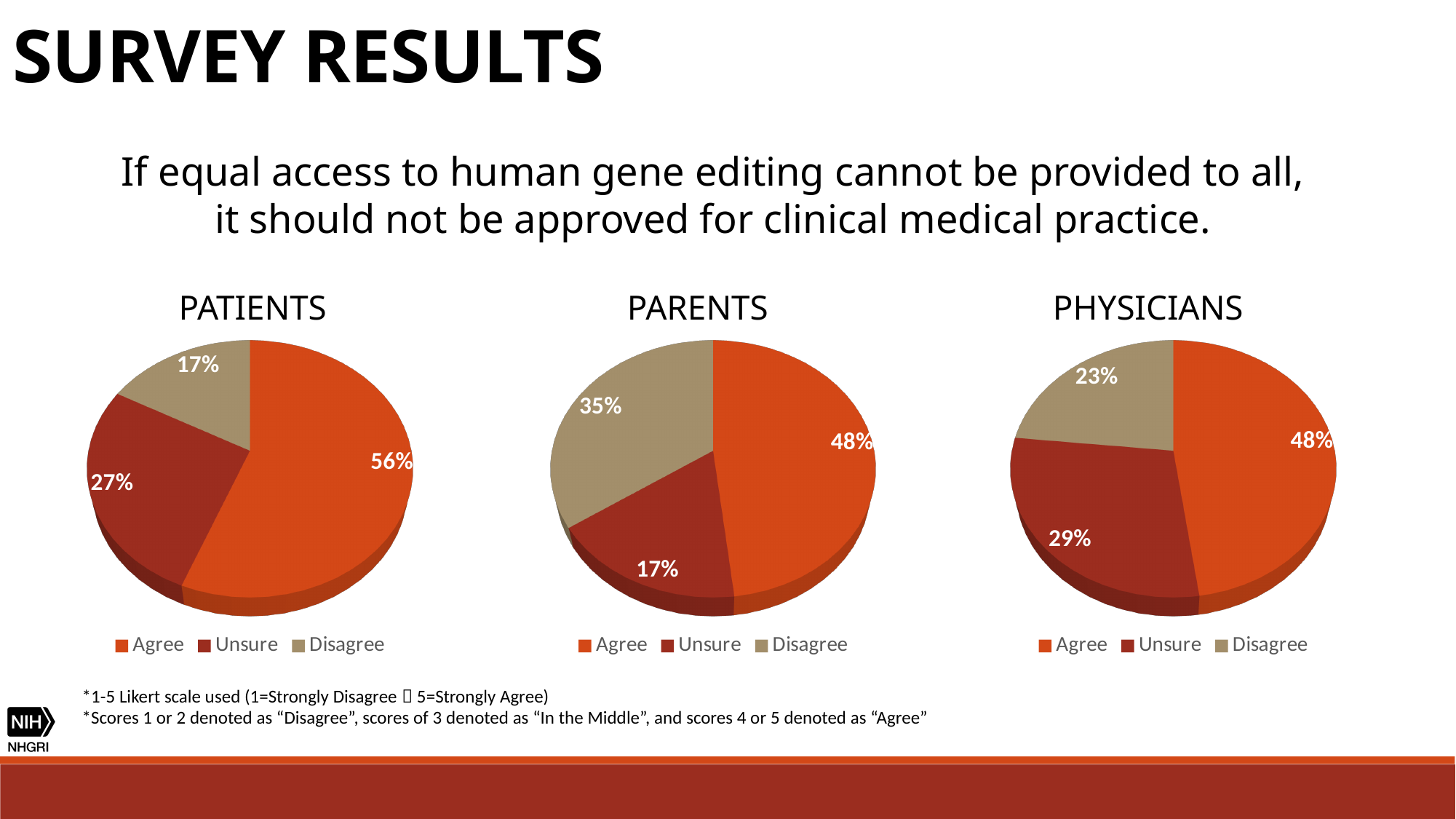
In the PATIENTS chart, which response has the smallest slice? Disagree How many entries does the legend of the PARENTS chart list? 3 In the PARENTS chart, what is the difference between the Disagree and Unsure percentages? 18% In the PATIENTS chart, what percentage of respondents chose Agree? 56% In the PATIENTS chart, what is the difference between the Agree and Unsure percentages? 29% In the PARENTS chart, which response has the largest slice? Agree How many slices does the PHYSICIANS chart have? 3 In the PARENTS chart, what percentage of respondents chose Disagree? 35% In the PHYSICIANS chart, what percentage of respondents chose Unsure? 29% In the PHYSICIANS chart, which response has the smallest slice? Disagree Is the Disagree share larger in the PARENTS chart or the PHYSICIANS chart? PARENTS What type of chart is used for the PATIENTS data? Pie chart